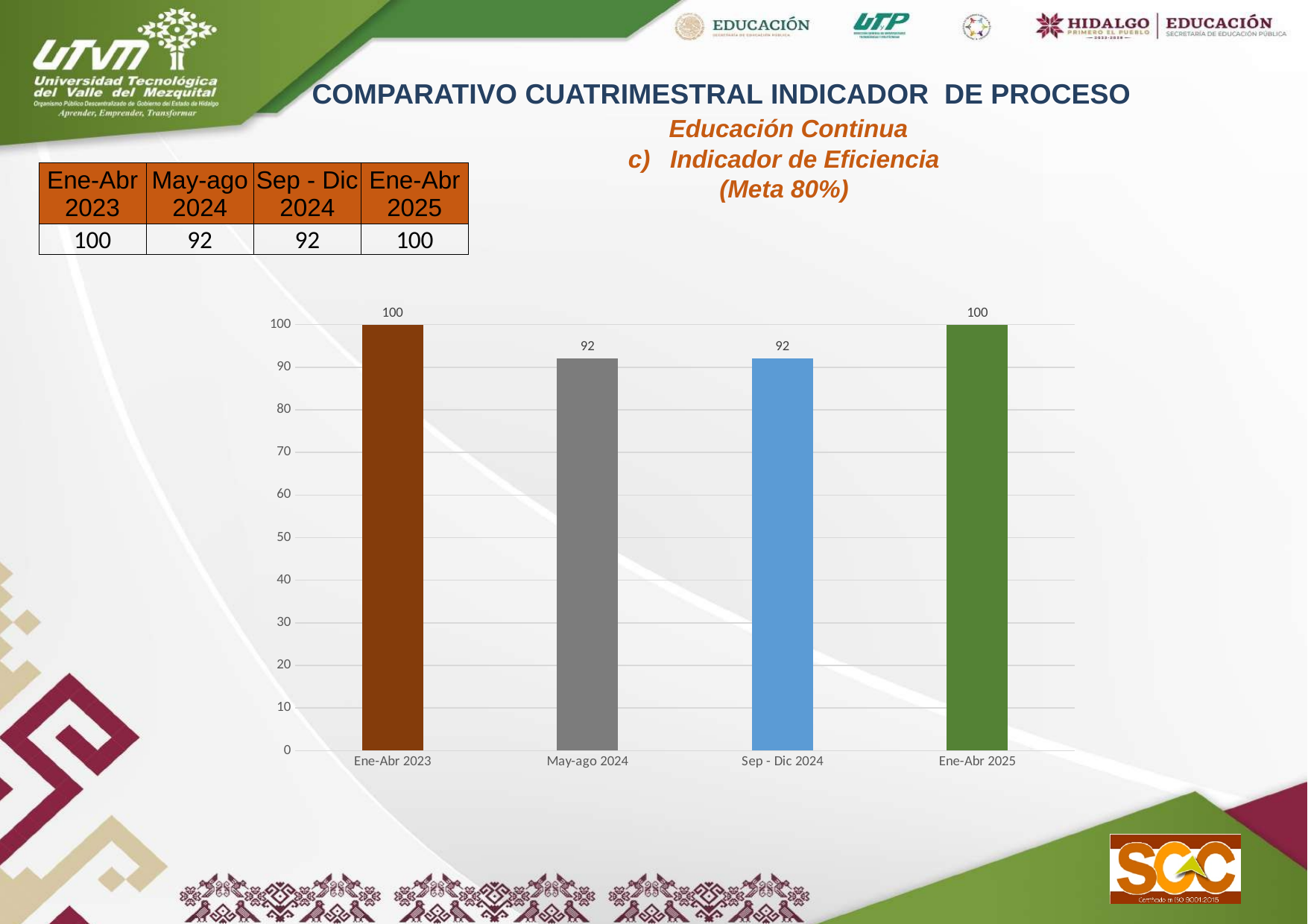
What is the value for Ene-Abr 2023? 100 What kind of chart is shown on the slide? bar chart What is the value for Ene-Abr 2025? 100 How many periods are shown on the x axis of the chart? 4 What is the difference between the values for Ene-Abr 2023 and May-ago 2024? 8 Which period has the lowest value, May-ago 2024 or Ene-Abr 2025? May-ago 2024 Which is larger, the value for Sep - Dic 2024 or the value for Ene-Abr 2025? Ene-Abr 2025 What colour is the bar for Ene-Abr 2025? green What is the value for Sep - Dic 2024? 92 Is the value for Sep - Dic 2024 greater or less than 80? greater Does the value rise or fall from Sep - Dic 2024 to Ene-Abr 2025? rise What is the value for May-ago 2024? 92